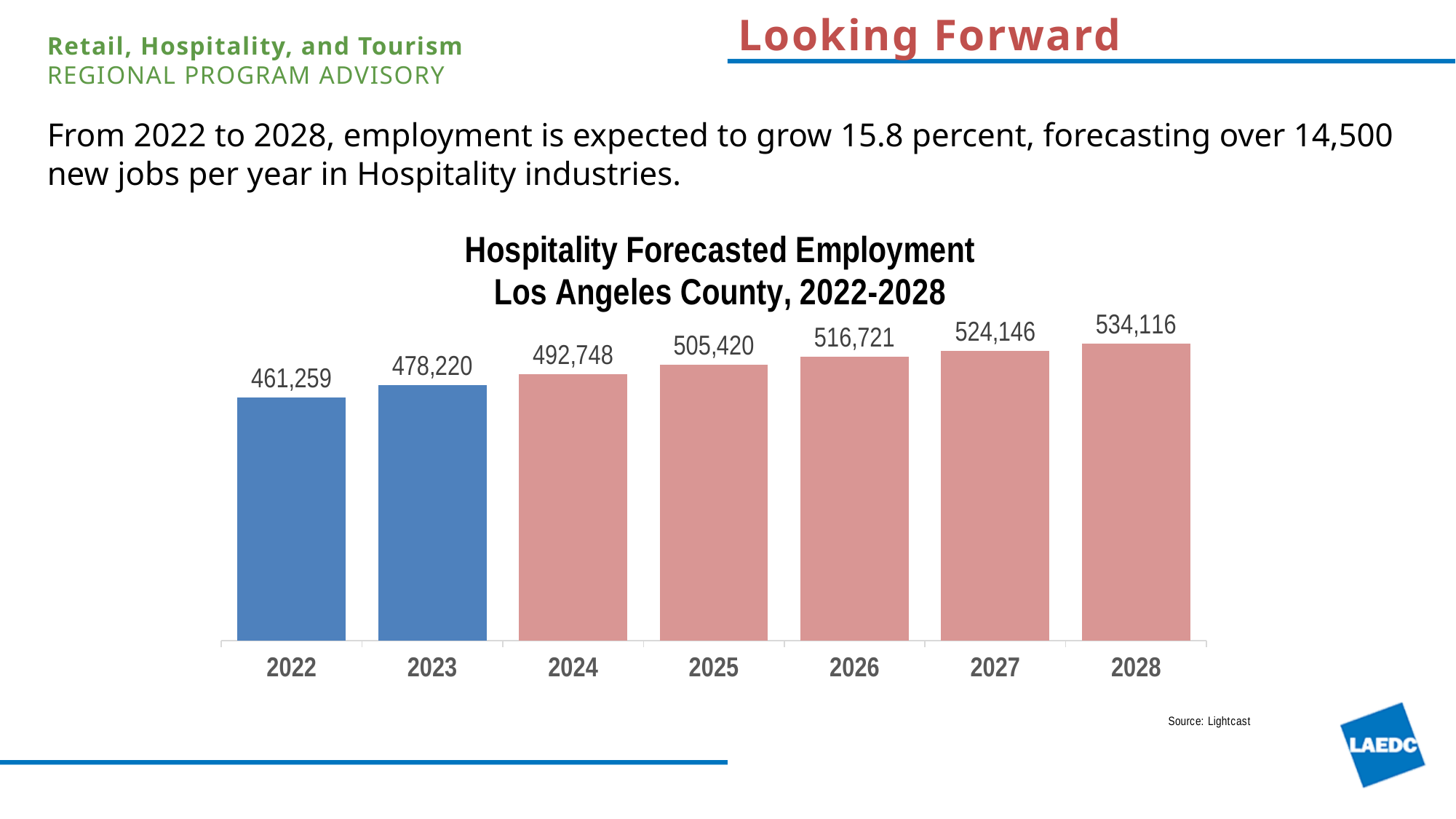
How many years are shown on the x axis of the chart? 7 What is the difference in forecasted employment between 2028 and 2022? 72,857 What is the forecasted hospitality employment for 2025? 505,420 Which year has the lowest forecasted employment? 2022 What is the forecasted hospitality employment for 2028? 534,116 What kind of chart is shown on the slide? Bar chart Which year has the highest forecasted employment? 2028 What is the difference in forecasted employment between 2024 and 2023? 14,528 What is the title of the chart? Hospitality Forecasted Employment Los Angeles County, 2022-2028 Do the forecasted employment values rise or fall from 2022 to 2028? Rise Which year has higher forecasted employment, 2026 or 2024? 2026 What is the forecasted hospitality employment for 2022? 461,259